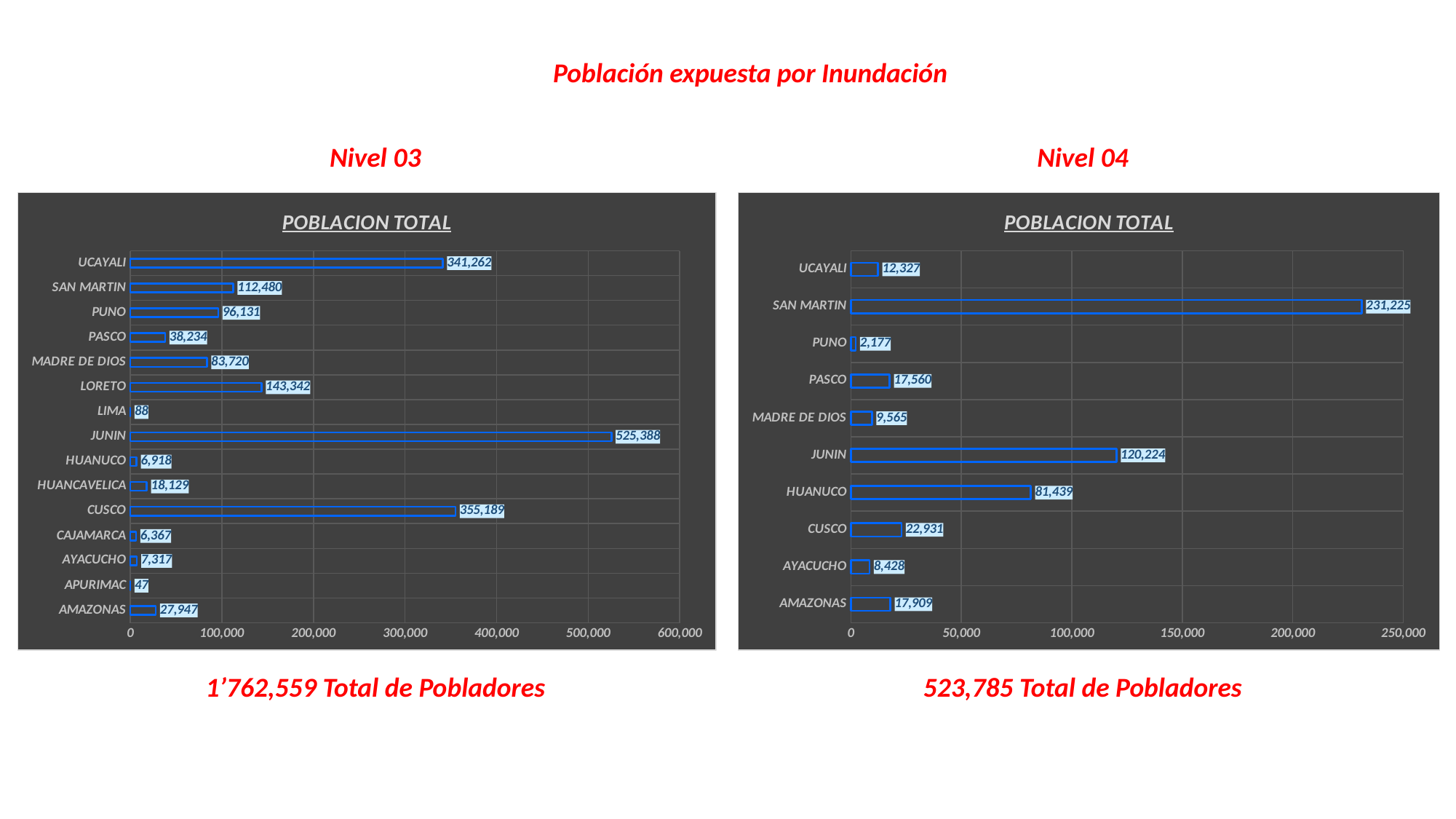
In the Nivel 03 chart, what is the difference between the values for JUNIN and CUSCO? 170,199 How many categories are shown in the Nivel 03 chart? 15 In the Nivel 03 chart, which category has the highest value? JUNIN In the Nivel 04 chart, which category has the highest value? SAN MARTIN In the Nivel 04 chart, what is the value for HUANUCO? 81,439 In the Nivel 03 chart, which is larger, the value for LORETO or the value for SAN MARTIN? LORETO In the Nivel 04 chart, what is the difference between the values for SAN MARTIN and JUNIN? 111,001 What kind of chart is the Nivel 04 chart? Bar chart In the Nivel 03 chart, what is the value for UCAYALI? 341,262 In the Nivel 03 chart, which category has the lowest value? APURIMAC In the Nivel 04 chart, which category has the lowest value? PUNO How many categories are shown in the Nivel 04 chart? 10